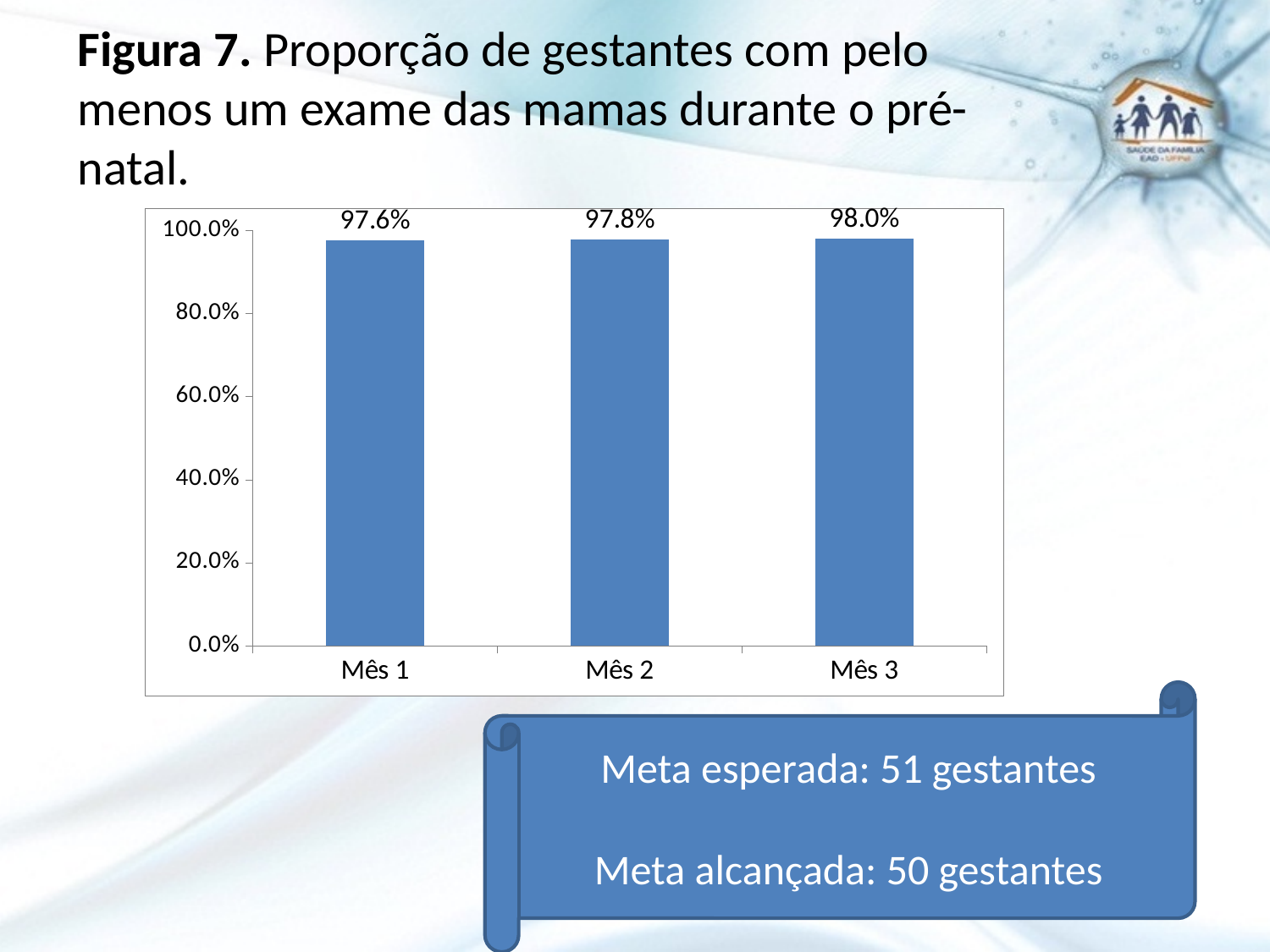
What is the value for Mês 1? 97.6% Which month has the lowest value? Mês 1 How many months are shown on the x axis? 3 What is the highest tick value shown on the y axis? 100.0% Which is larger, the value for Mês 2 or the value for Mês 1? Mês 2 Do the values rise or fall from Mês 1 to Mês 3? rise What is the difference between the values for Mês 3 and Mês 1? 0.4% Is the value for Mês 2 greater or less than 80.0%? greater What is the value for Mês 3? 98.0% What is the value for Mês 2? 97.8% Which month has the highest value? Mês 3 What kind of chart is shown on the slide? bar chart